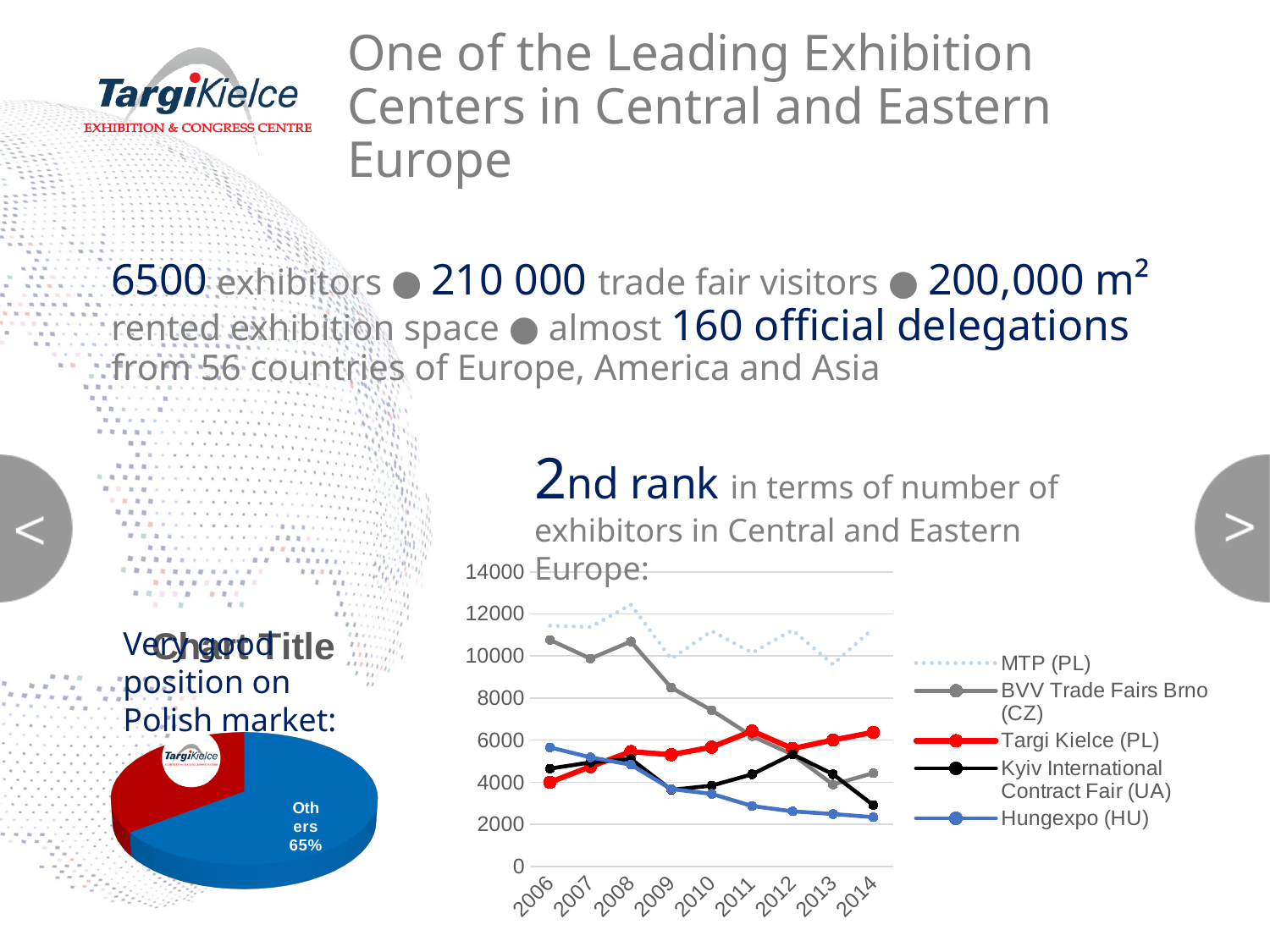
On the line chart on the right, how many years are shown on the x axis? 9 On the line chart on the right, what colour is the Targi Kielce (PL) line? red On the line chart on the right, which series has the lowest value in 2006? Targi Kielce (PL) On the line chart on the right, is the value for BVV Trade Fairs Brno (CZ) in 2006 greater or less than 10000? greater On the pie chart on the left, what share does the Others slice have? 65% On the line chart on the right, which series has the highest value in 2014? MTP (PL) On the line chart on the right, is the value for Hungexpo (HU) in 2014 greater or less than 4000? less On the line chart on the right, which is larger in 2014: Targi Kielce (PL) or BVV Trade Fairs Brno (CZ)? Targi Kielce (PL) On the line chart on the right, what kind of chart is it? line chart On the line chart on the right, do the values for Targi Kielce (PL) generally rise or fall from 2006 to 2014? rise On the line chart on the right, do the values for Hungexpo (HU) generally rise or fall from 2006 to 2014? fall On the line chart on the right, how many series does the legend list? 5